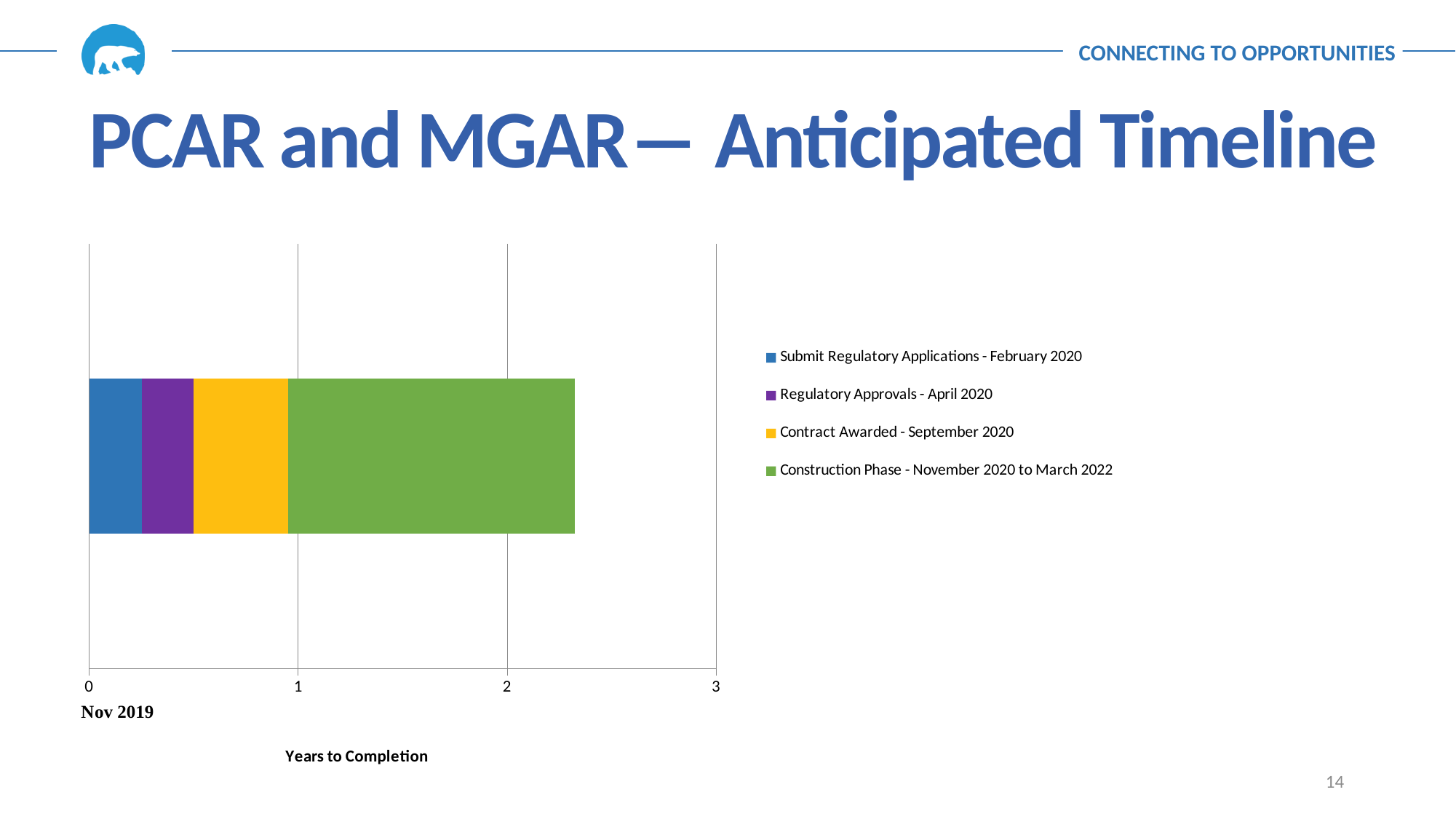
Is the length of the Construction Phase segment greater or less than 1 year? greater Is the total length of the stacked bar greater or less than 3 years? less Which is longer, the Contract Awarded segment or the Regulatory Approvals segment? Contract Awarded Which is longer, the Construction Phase segment or the Contract Awarded segment? Construction Phase What is the title of the horizontal axis? Years to Completion What kind of chart is shown on the slide? bar chart How many series does the legend list? 4 Is the length of the Submit Regulatory Applications segment greater or less than 1 year? less How many stacked bars are plotted in the chart? 1 Which segment of the stacked bar is the longest? Construction Phase - November 2020 to March 2022 Which legend entry is shown in green? Construction Phase - November 2020 to March 2022